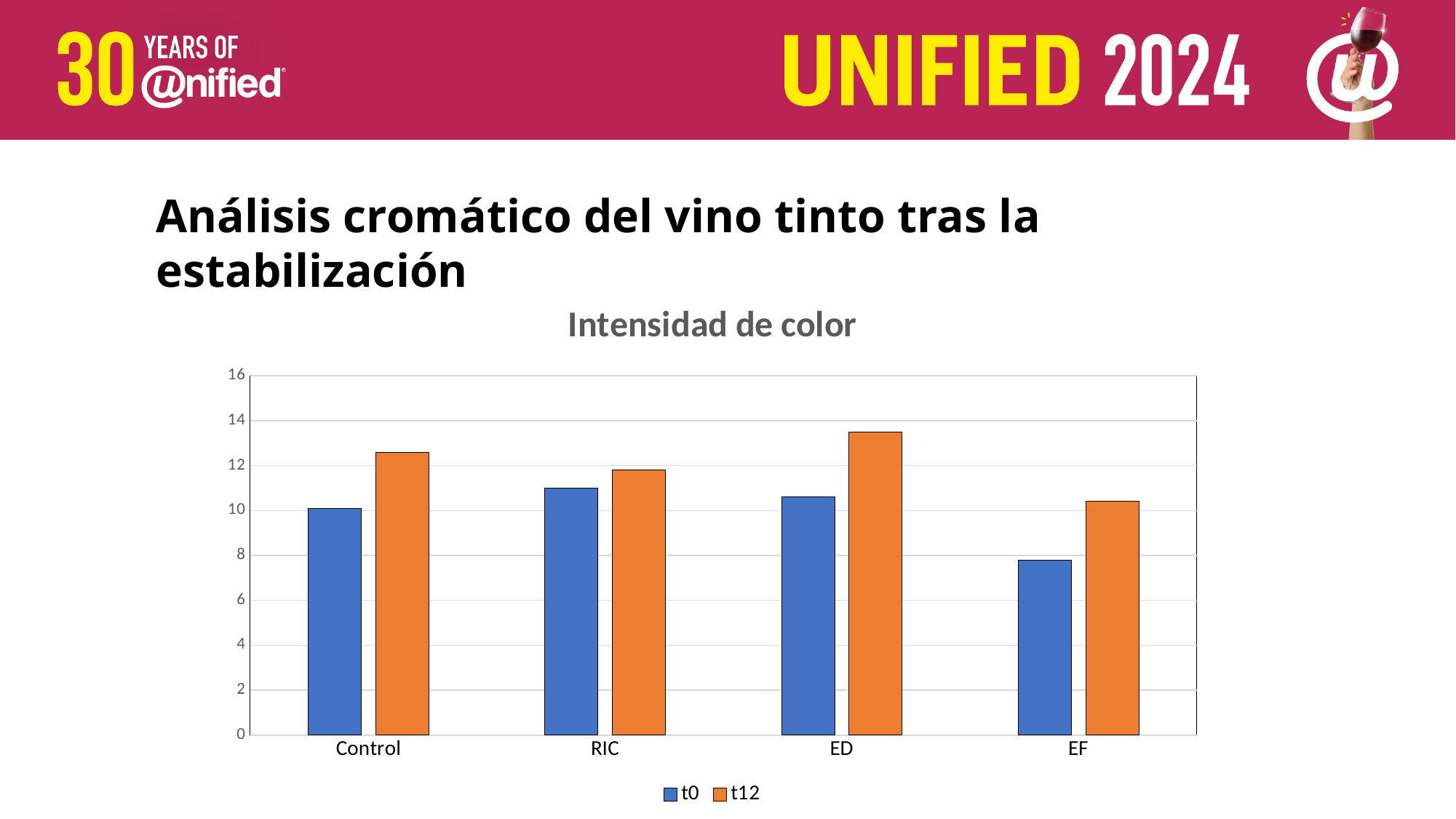
Is the t12 value for Control greater or less than 12? greater Which category has the highest t12 value? ED For EF, which is larger, the t0 value or the t12 value? t12 What is the title of the chart? Intensidad de color Which category has the lowest t0 value? EF How many categories are shown on the x axis? 4 What type of chart is shown on the slide? bar chart Which is larger, the t12 value for Control or the t12 value for RIC? Control Is the t12 value for ED greater or less than 12? greater How many series does the legend list? 2 Is the t0 value for RIC greater or less than 10? greater